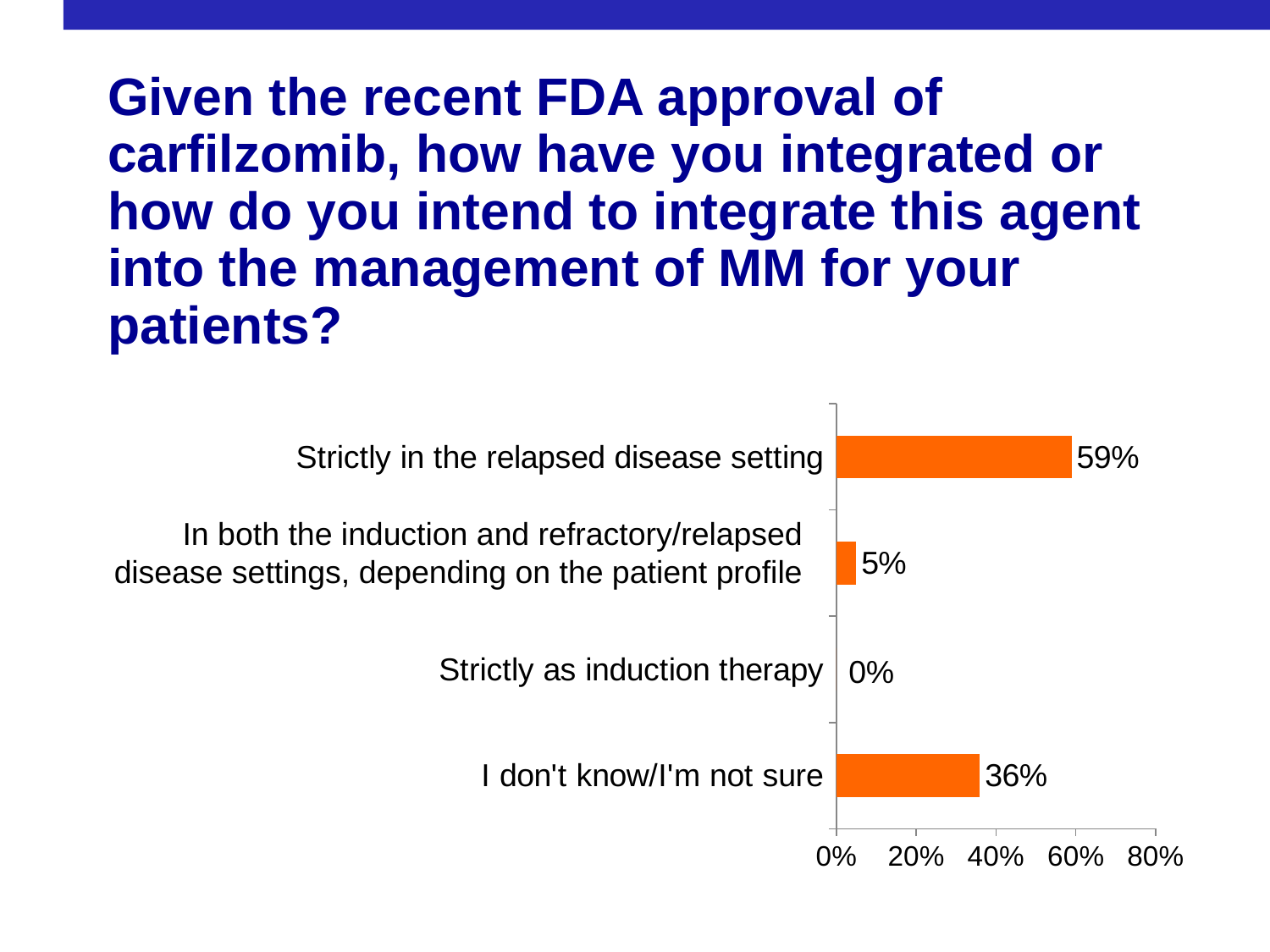
What is the highest value shown on the x axis of the chart? 80% Which response option has the lowest percentage? Strictly as induction therapy What percentage of respondents chose "Strictly in the relapsed disease setting"? 59% How many response options are shown in the chart? 4 What percentage of respondents chose "In both the induction and refractory/relapsed disease settings, depending on the patient profile"? 5% Which has a larger percentage: "I don't know/I'm not sure" or "In both the induction and refractory/relapsed disease settings, depending on the patient profile"? I don't know/I'm not sure What percentage of respondents chose "I don't know/I'm not sure"? 36% What percentage of respondents chose "Strictly as induction therapy"? 0% What is the difference in percentage points between "Strictly in the relapsed disease setting" and "I don't know/I'm not sure"? 23 percentage points Is the value for "Strictly in the relapsed disease setting" greater or less than 40%? greater What kind of chart is shown on the slide? Bar chart Which response option has the highest percentage? Strictly in the relapsed disease setting